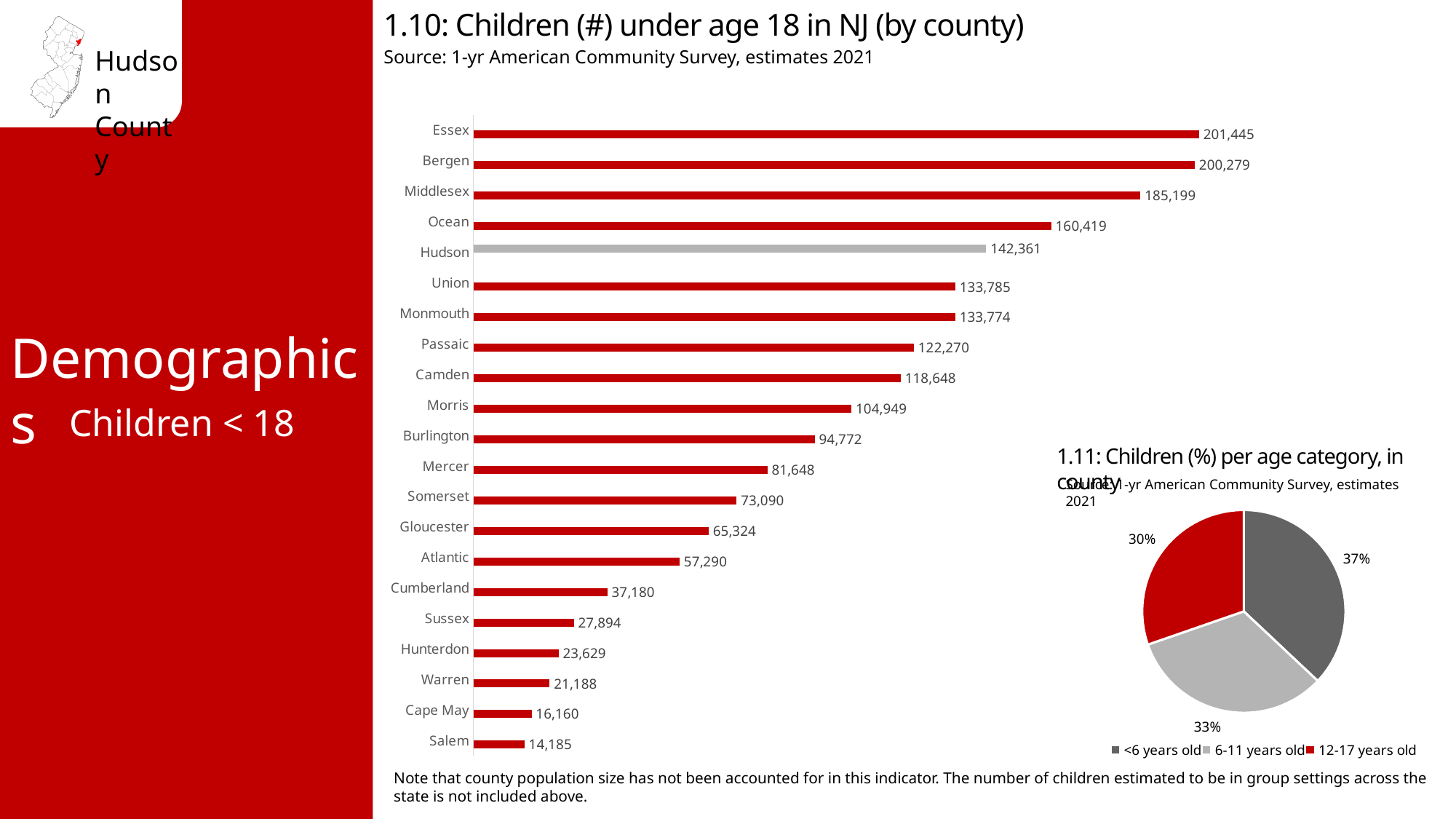
In chart 1.11, what share of children are under 6 years old? 37% In chart 1.10, what is the value for Passaic? 122,270 In chart 1.10, which county's bar is coloured grey instead of red? Hudson In chart 1.10, which county has the lowest number of children under 18? Salem What kind of chart is chart 1.10? Bar chart In chart 1.10, how many counties are shown? 21 In chart 1.10, how many children under age 18 are in Hudson County? 142,361 In chart 1.10, which county has the highest number of children under 18? Essex In chart 1.11, what percentage of children are 12-17 years old? 30% How many categories does the legend of chart 1.11 list? 3 In chart 1.10, what is the difference between the values for Essex and Bergen? 1,166 In chart 1.10, which county has more children under 18, Ocean or Hudson? Ocean